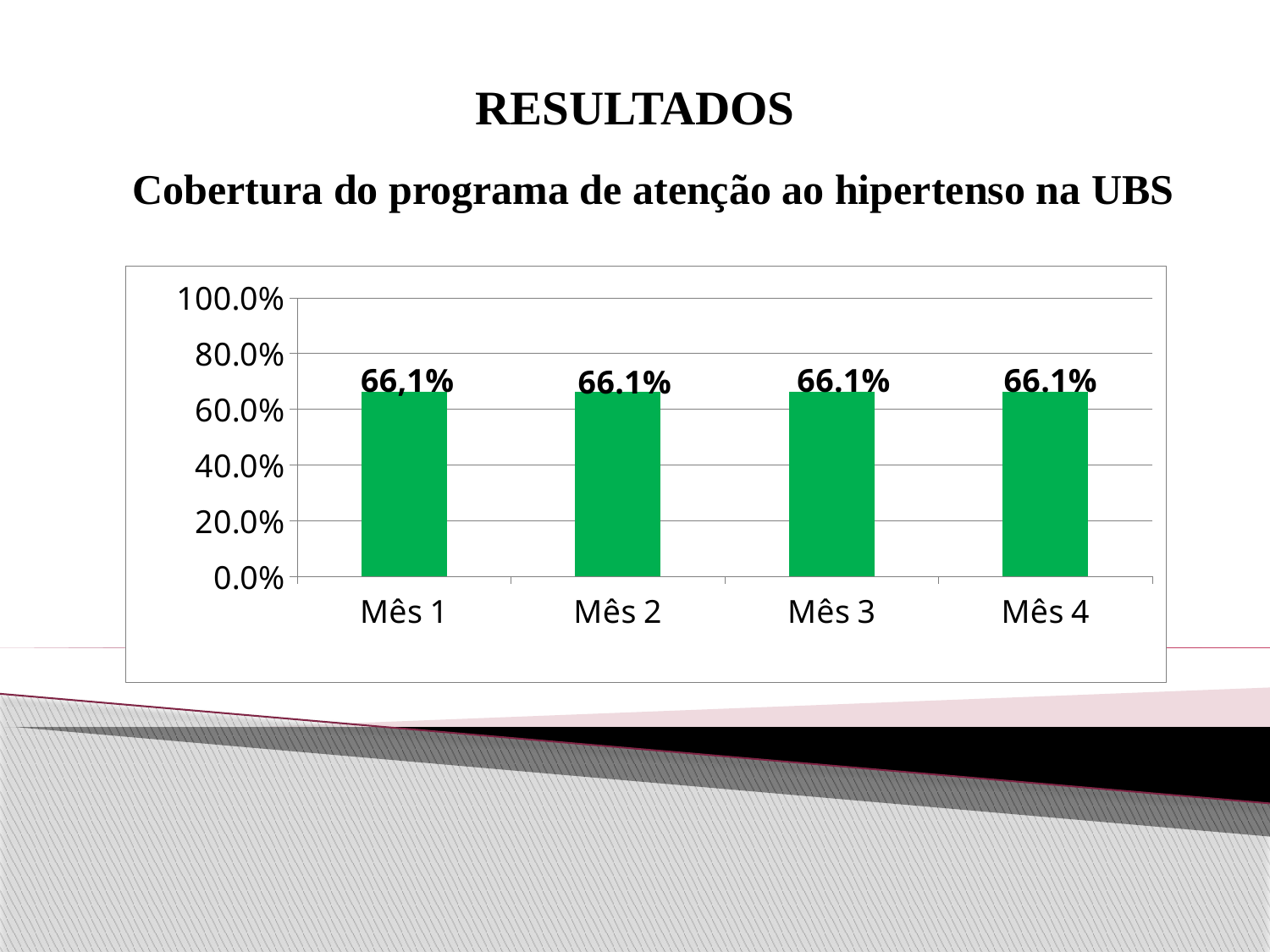
What is the value for Mês 3? 66.1% Is the value for Mês 2 greater or less than 80.0%? less What is the difference between the values for Mês 2 and Mês 4? 0.0% Do the values rise, fall or stay the same from Mês 1 to Mês 4? stay the same What is the value for Mês 4? 66.1% What colour are the bars in the chart? green What is the value for Mês 1? 66,1% Is the value for Mês 3 greater or less than 60.0%? greater What is the title of the chart on the slide? Cobertura do programa de atenção ao hipertenso na UBS How many categories are shown on the x axis? 4 What kind of chart is shown on the slide? bar chart